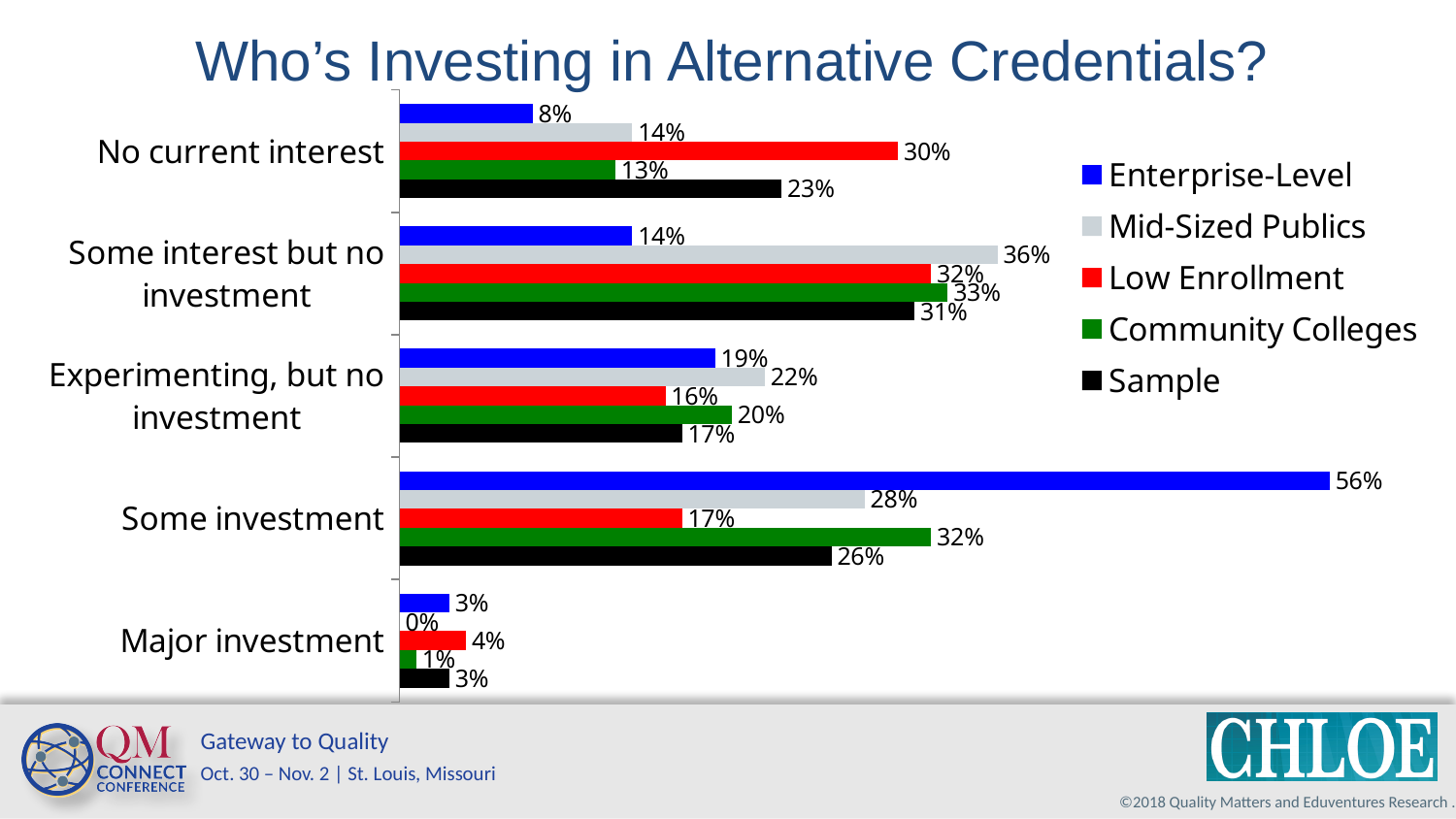
Which series has the highest value for Some interest but no investment? Mid-Sized Publics Which is larger for No current interest: the Sample value or the Community Colleges value? Sample Which series has the lowest value for Major investment? Mid-Sized Publics What is the Community Colleges value for Experimenting, but no investment? 20% What is the difference between the Enterprise-Level and Mid-Sized Publics values for Some investment? 28% What is the Low Enrollment value for No current interest? 30% How many series does the legend list? 5 What is the Sample value for Some interest but no investment? 31% What kind of chart is shown on the slide? Bar chart What is the Enterprise-Level value for Some investment? 56% How many categories are shown on the chart? 5 What is the title of the chart? Who's Investing in Alternative Credentials?